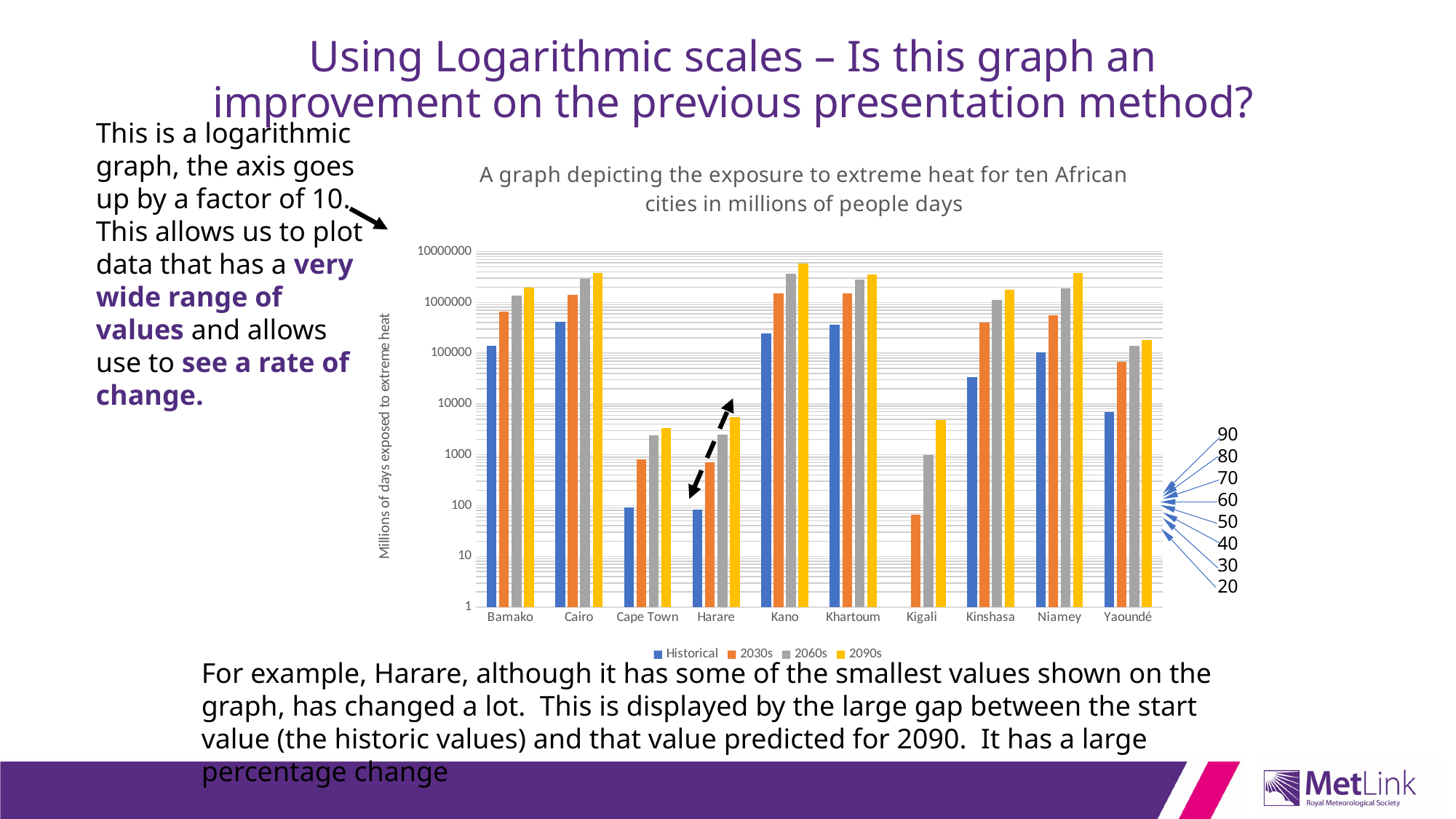
Is the 2030s value for Kigali greater or less than 100? less How many cities are shown on the x axis of the chart? 10 What is the label on the vertical axis of the chart? Millions of days exposed to extreme heat Which city has the lowest 2030s value in the chart? Kigali What kind of chart is shown on the slide? Bar chart How many series does the chart legend list? 4 For Harare, do the values rise or fall from Historical through to 2090s? rise Which is larger, the Historical value for Cairo or the Historical value for Bamako? Cairo Is the 2090s value for Kano greater or less than 1000000? greater Is the 2090s value for Harare greater or less than 10000? less Which city has the highest 2090s value in the chart? Kano